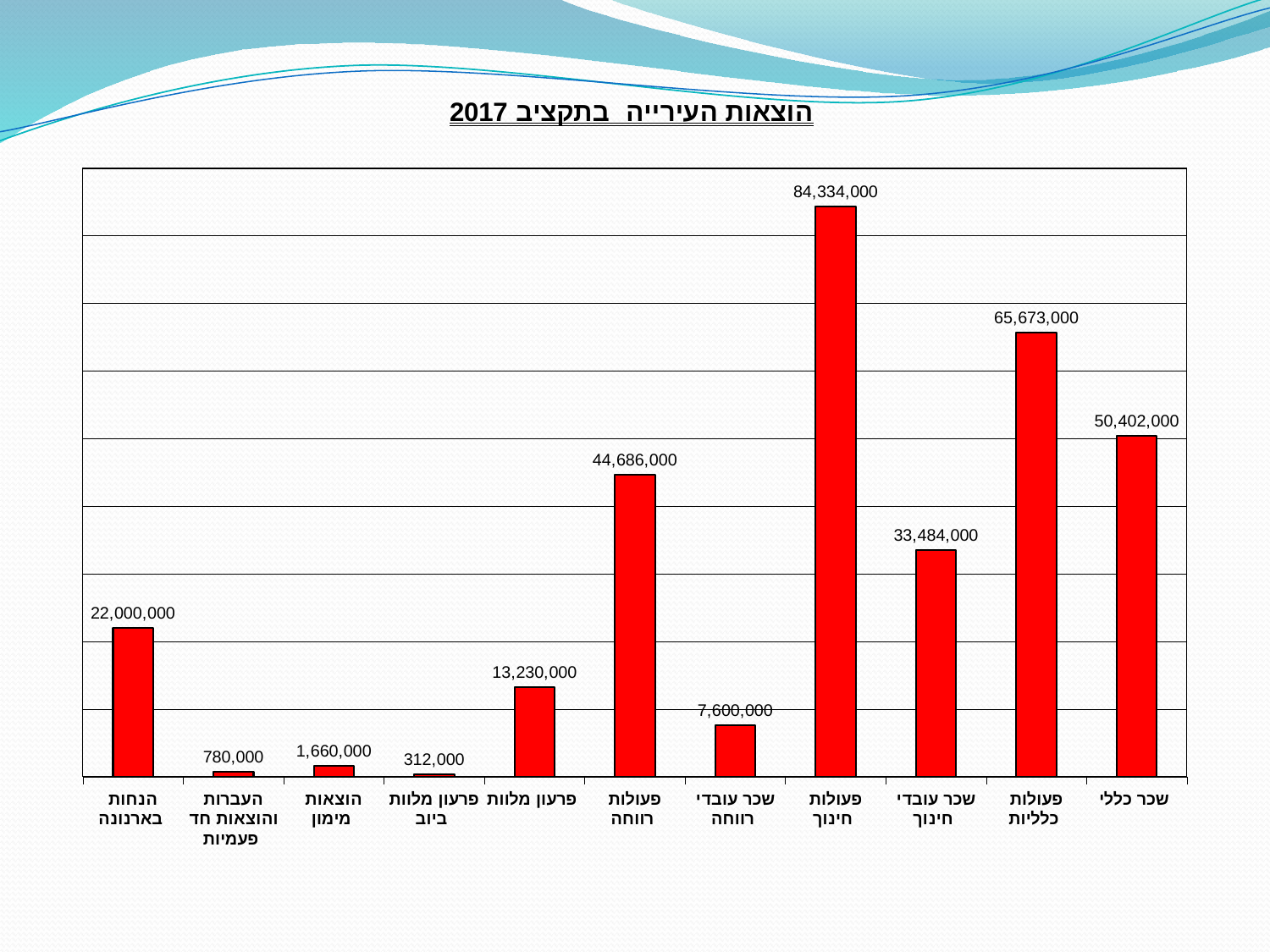
What is the title of the chart? הוצאות העירייה בתקציב 2017 What is the difference between פעולות חינוך and שכר עובדי חינוך? 50,850,000 Which category has the lowest value? פרעון מלוות ביוב How many categories are shown in the chart? 11 What is the value for פרעון מלוות ביוב? 312,000 What is the value for שכר כללי? 50,402,000 Which is larger, פעולות רווחה or שכר עובדי חינוך? פעולות רווחה Which category has the highest value? פעולות חינוך What is the difference between פעולות כלליות and שכר כללי? 15,271,000 What kind of chart is shown on the slide? bar chart What is the value for פעולות חינוך? 84,334,000 What is the value for הנחות בארנונה? 22,000,000